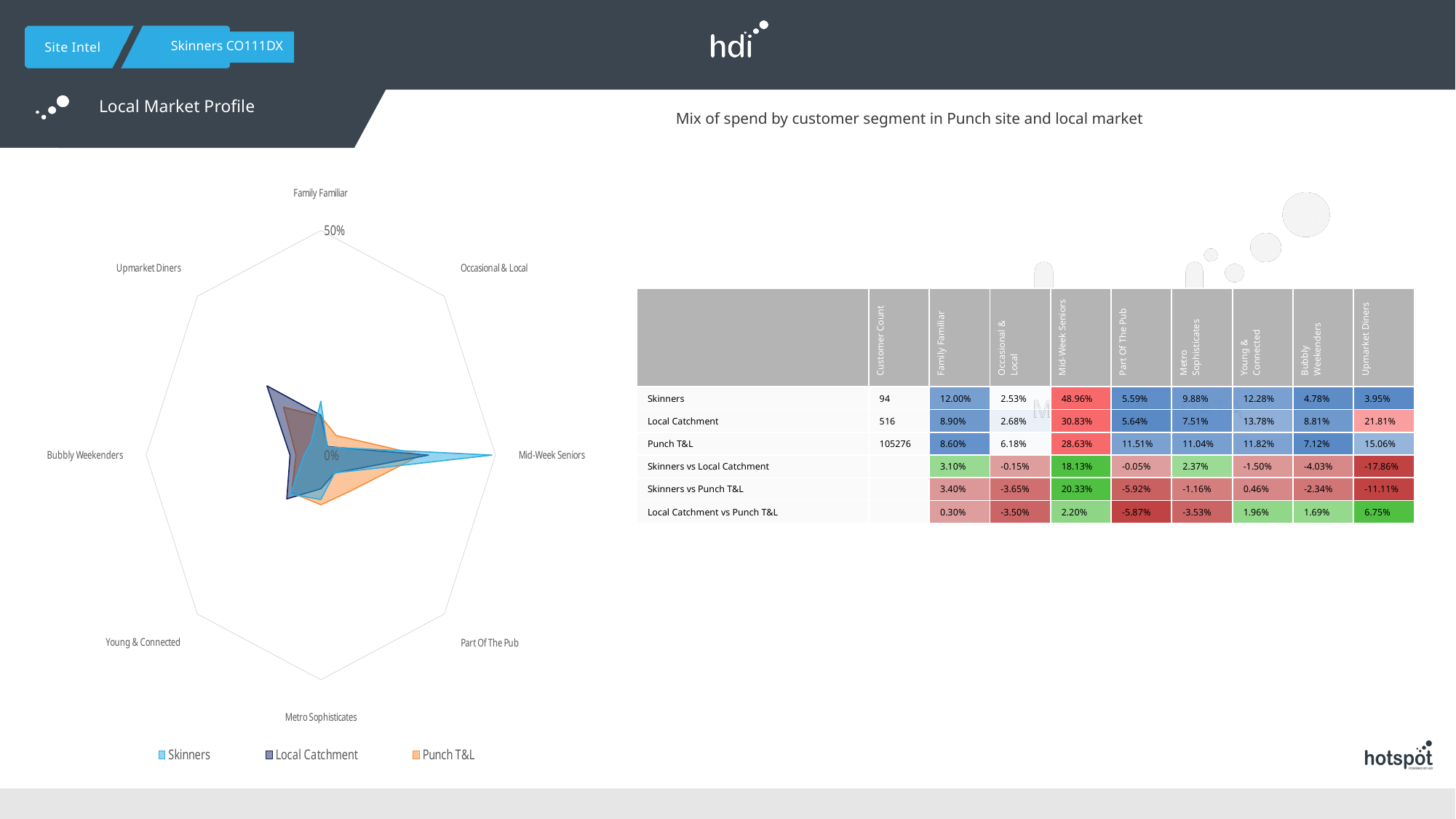
On the radar chart, which segment has the highest value for the Punch T&L series? Mid-Week Seniors On the radar chart, which segment has the highest value for the Skinners series? Mid-Week Seniors On the radar chart, is the Skinners value for Mid-Week Seniors larger or smaller than the Local Catchment value for Mid-Week Seniors? larger What kind of chart is shown on the left of the slide? radar chart What is the maximum value shown on the radar chart's axis scale? 50% How many customer segments (axes) does the radar chart have? 8 On the radar chart, which series has the larger value for Upmarket Diners: Skinners or Local Catchment? Local Catchment On the radar chart, is the Local Catchment value for Upmarket Diners greater or less than 50%? less How many series does the radar chart's legend list? 3 According to the table, what is the Skinners value for Mid-Week Seniors? 48.96% According to the table, what is the Punch T&L value for Part Of The Pub? 11.51% Which series are listed in the radar chart's legend? Skinners, Local Catchment, Punch T&L